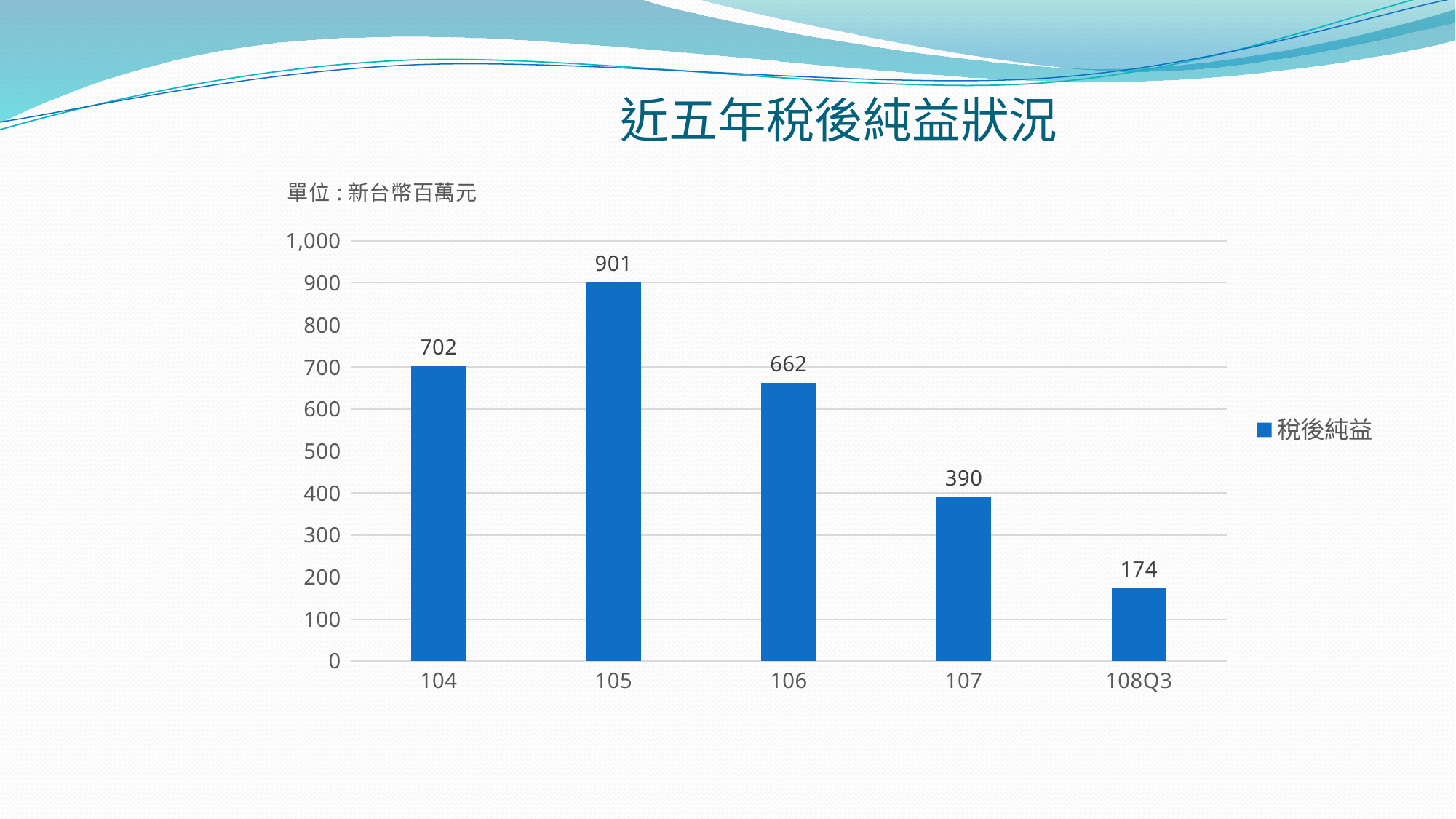
What is the difference between the values for 105 and 106? 239 What is the difference between the values for 107 and 108Q3? 216 Which category has the highest value? 105 What is the value for 104? 702 Is the value for 107 greater or less than 400? less What is the value for 105? 901 What kind of chart is shown on the slide? bar chart Which category has the lowest value? 108Q3 What is the title of the chart? 近五年稅後純益狀況 What is the value for 108Q3? 174 Which is larger, the value for 104 or the value for 106? 104 How many categories are shown on the x axis? 5